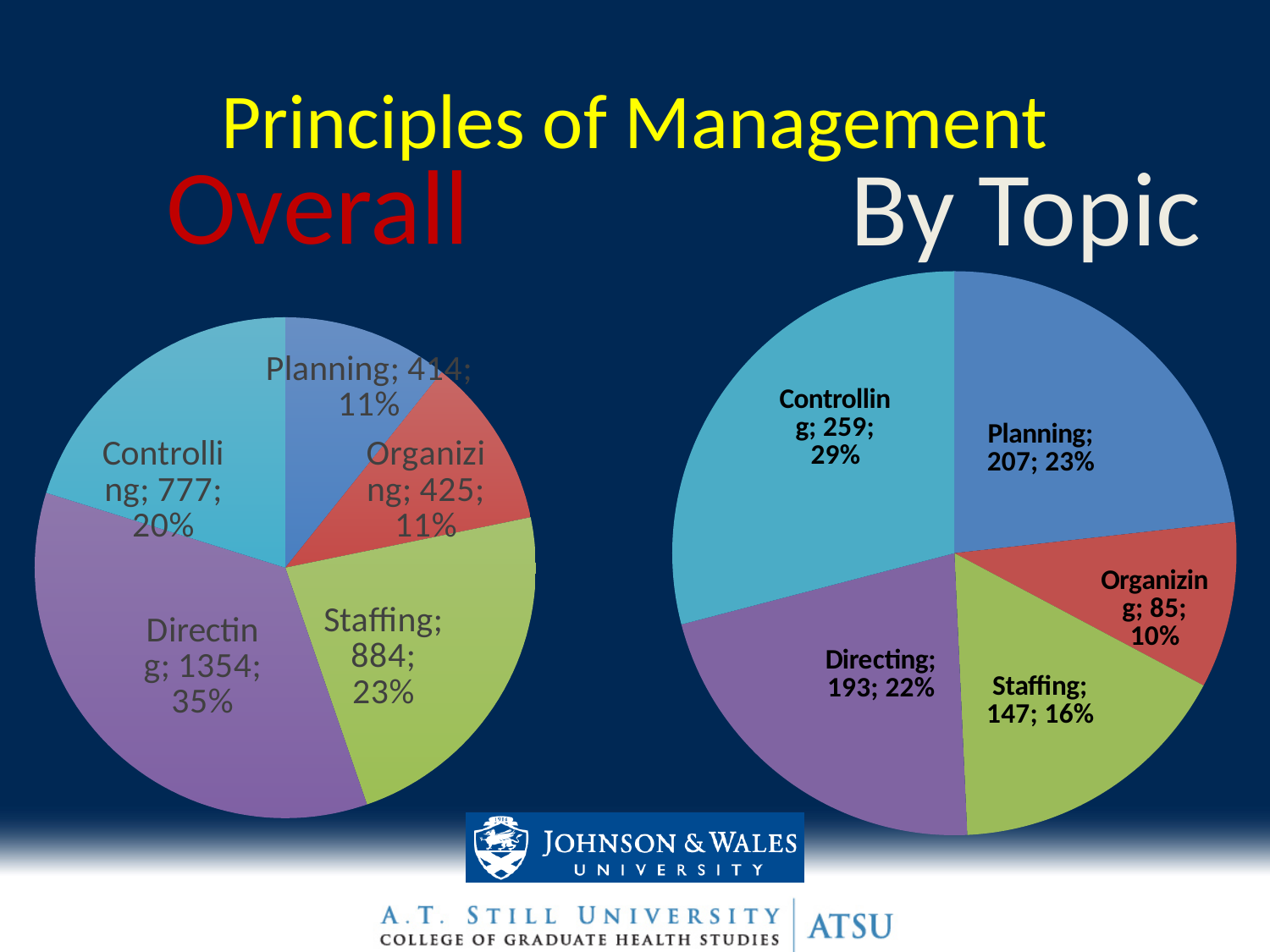
What is the title of the chart on the right side of the slide? By Topic In the By Topic pie chart, what is the value for Controlling? 259 What type of chart is the Overall chart? Pie chart In the Overall pie chart, which category has the largest slice? Directing In the By Topic pie chart, which category has the smallest slice? Organizing How many categories does the By Topic pie chart show? 5 In the Overall pie chart, what percentage share does Staffing have? 23% In the By Topic pie chart, what percentage share does Organizing have? 10% In the Overall pie chart, what is the difference between the values for Directing and Staffing? 470 In the Overall pie chart, which is larger, the value for Controlling or the value for Organizing? Controlling In the By Topic pie chart, what is the difference between the values for Planning and Staffing? 60 In the Overall pie chart, what is the value for Directing? 1354